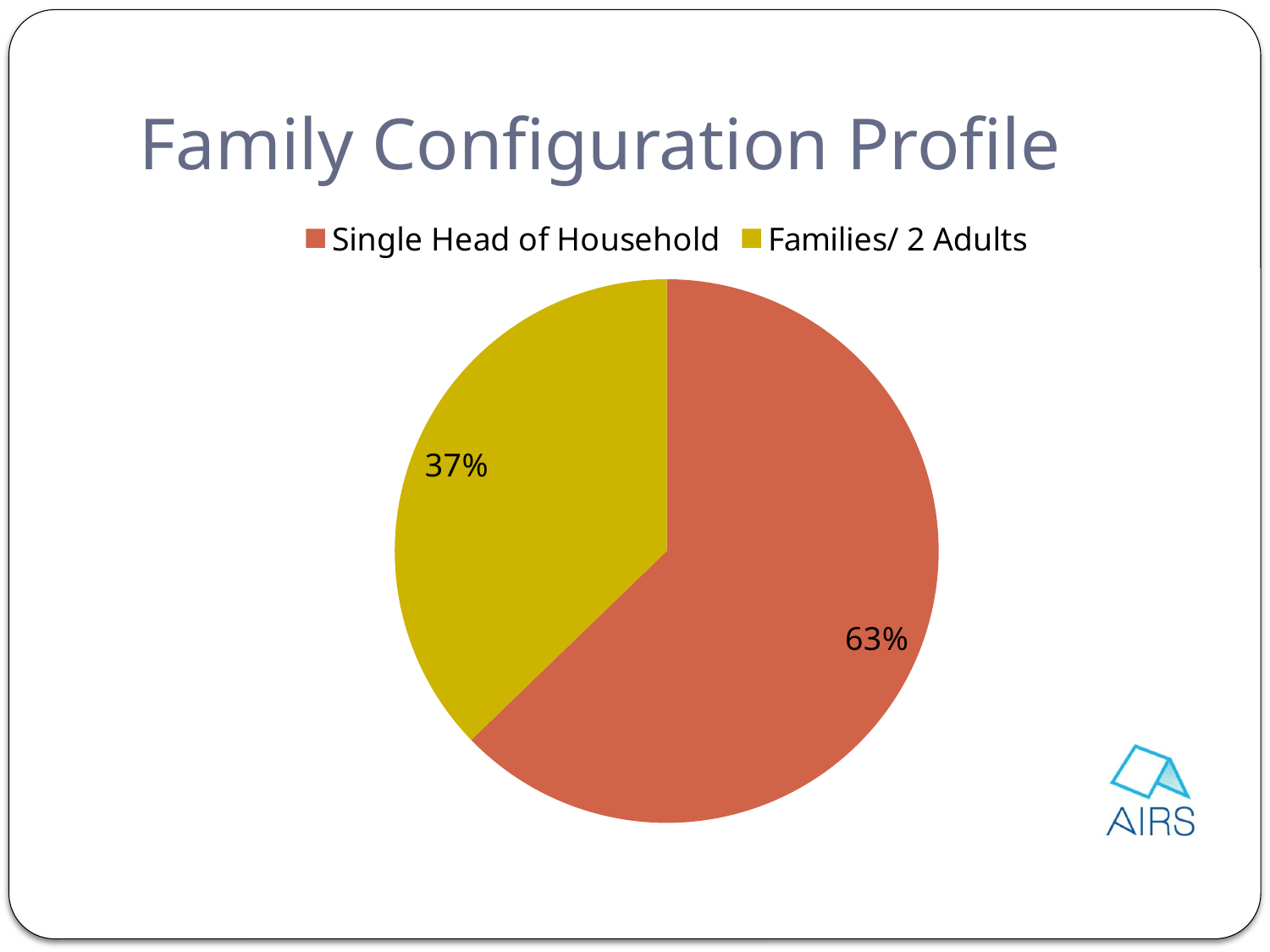
What percentage of the pie is Single Head of Household? 63% Which category has the smallest share of the pie? Families/ 2 Adults How many slices does the pie chart have? 2 Which category has the largest share of the pie? Single Head of Household What colour is the Families/ 2 Adults slice? yellow What kind of chart is shown on the slide? pie chart What percentage of the pie is Families/ 2 Adults? 37% What share of the pie does the Single Head of Household slice represent? 63% What is the difference in percentage points between Single Head of Household and Families/ 2 Adults? 26 How many entries does the legend list? 2 What is the title of the chart? Family Configuration Profile Which is larger, the share for Single Head of Household or the share for Families/ 2 Adults? Single Head of Household